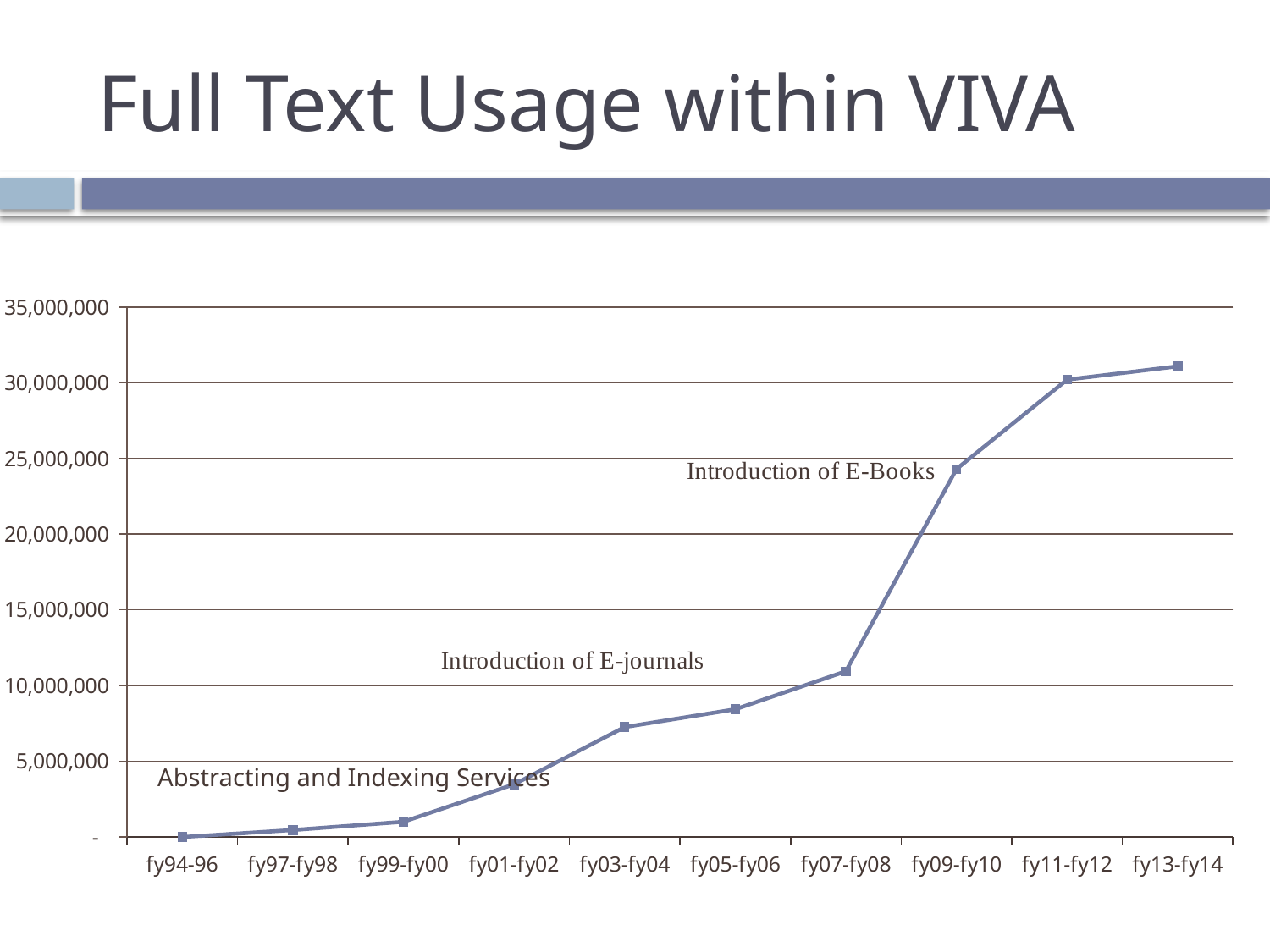
What is the title of the slide containing the chart? Full Text Usage within VIVA How many fiscal-year periods are plotted along the x axis? 10 Which fiscal-year period has the highest full text usage? fy13-fy14 Is the value for fy09-fy10 greater or less than 20,000,000? greater Is the value for fy03-fy04 greater or less than 5,000,000? greater Which fiscal-year period has the lowest full text usage? fy94-96 Do the values rise or fall from fy94-96 to fy13-fy14? rise What annotation is placed near the fy09-fy10 point on the chart? Introduction of E-Books Is the value for fy07-fy08 greater or less than 15,000,000? less What kind of chart is shown on the slide? line chart Which is larger, the value for fy05-fy06 or the value for fy09-fy10? fy09-fy10